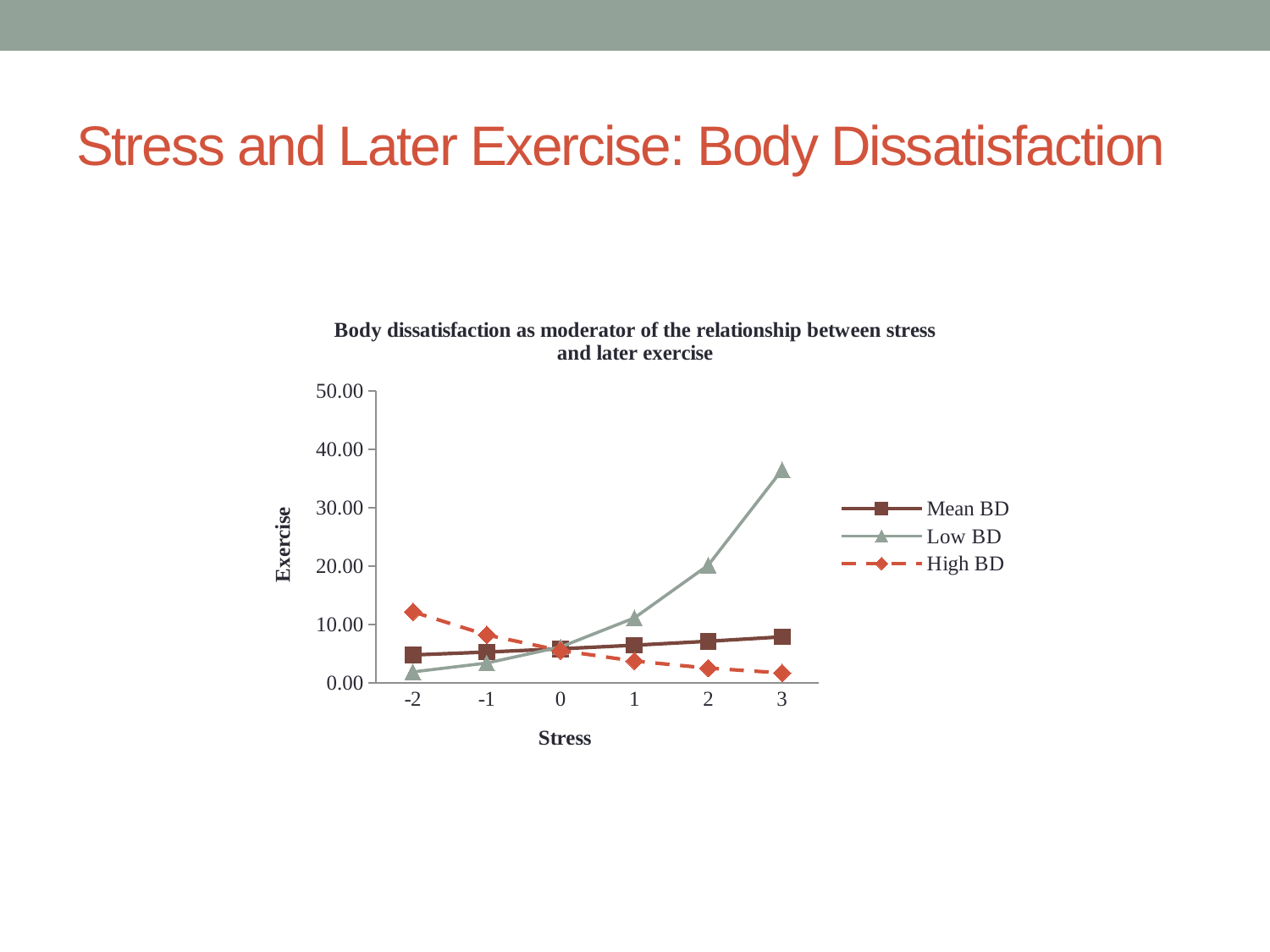
Which series has the lowest Exercise value at Stress -2? Low BD Does the High BD line rise or fall as Stress increases? falls Is the Mean BD value at Stress 3 greater or less than 10.00? less Is the Low BD value at Stress 3 greater or less than 30.00? greater At Stress -2, which is larger: the High BD value or the Low BD value? High BD Does the Low BD line rise or fall as Stress increases? rises Which series has the highest Exercise value at Stress 3? Low BD How many Stress values are plotted along the x axis? 6 Is the High BD value at Stress -2 greater or less than 10.00? greater What is the label on the y axis of the chart? Exercise How many series does the legend list? 3 What kind of chart is shown on the slide? line chart